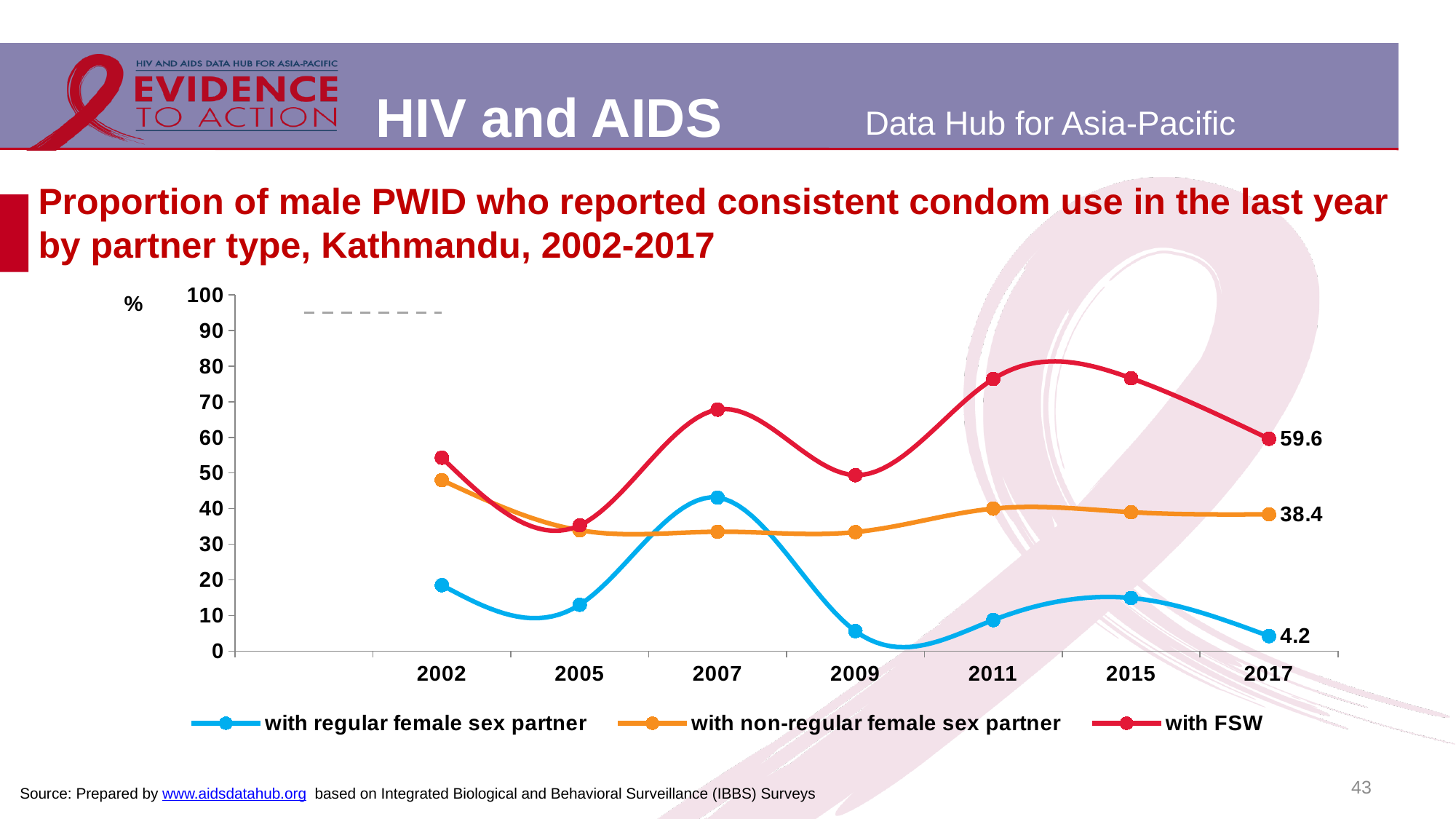
Is the value for 'with regular female sex partner' in 2009 greater or less than 10? less In 2017, what is the difference between the 'with FSW' value and the 'with non-regular female sex partner' value? 21.2 How many years are shown on the x axis? 7 What is the value for 'with regular female sex partner' in 2017? 4.2 What kind of chart is shown on the slide? line chart What is the value for 'with FSW' in 2017? 59.6 How many series does the legend list? 3 Is the value for 'with FSW' in 2007 greater or less than 60? greater In which year does the 'with regular female sex partner' series reach its highest value? 2007 What is the value for 'with non-regular female sex partner' in 2017? 38.4 In 2017, what is the difference between the 'with non-regular female sex partner' value and the 'with regular female sex partner' value? 34.2 Which series has the highest value in 2017? with FSW